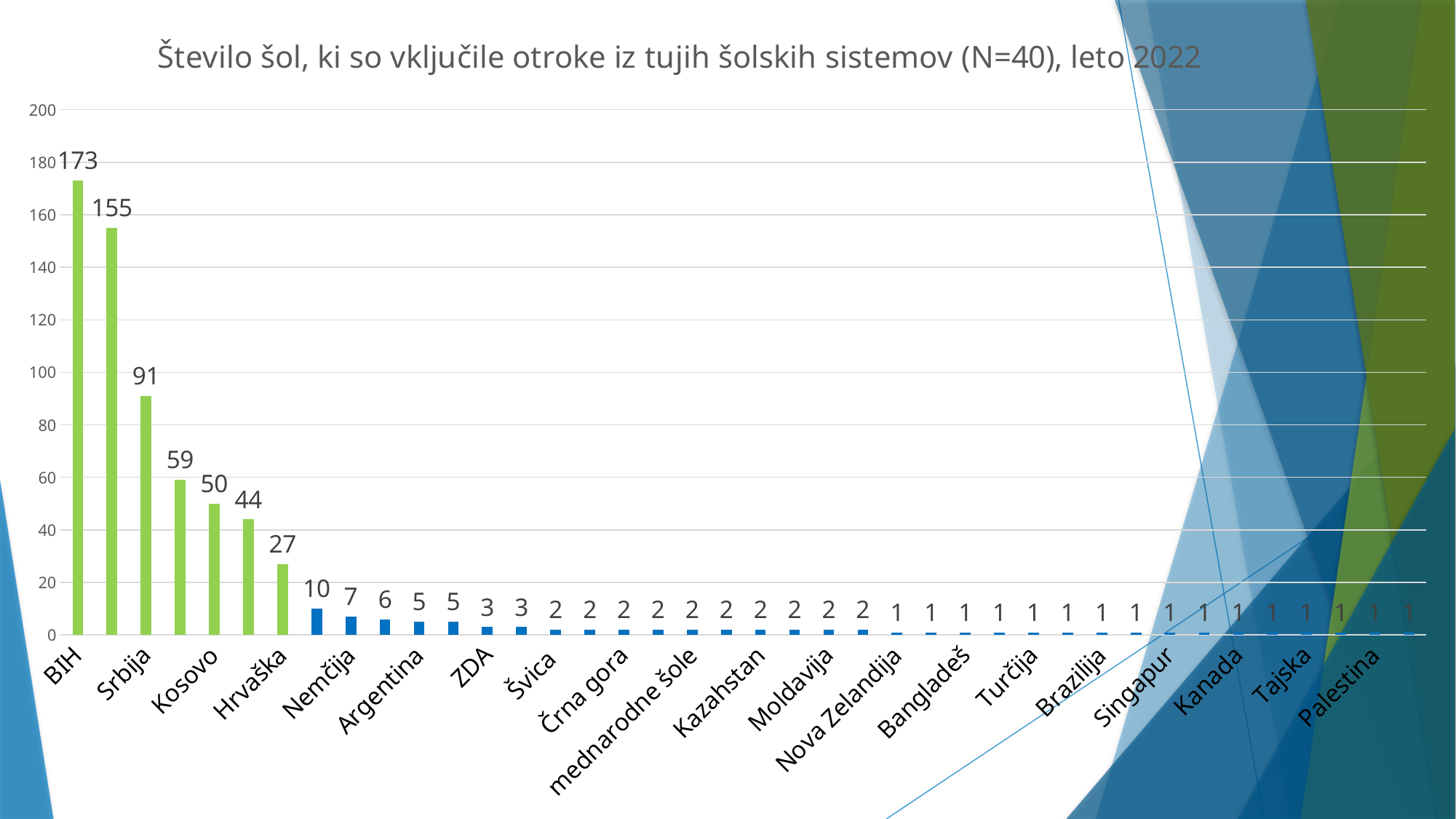
How many bars are coloured green rather than blue? 7 What is the lowest value shown on any bar in the chart? 1 Do the bar values rise or fall from left to right along the x axis? fall What is the difference between the two tallest bars (173 and 155)? 18 What is the value of the second-tallest bar in the chart? 155 Is the value for BIH greater or less than 160? greater What is the title of the chart? Število šol, ki so vključile otroke iz tujih šolskih sistemov (N=40), leto 2022 Which is larger, the value for BIH or the value of the bar labelled 155? BIH Which category has the highest value in the chart? BIH What is the value for BIH? 173 How many bars have a value of 1? 16 What kind of chart is shown on the slide? bar chart